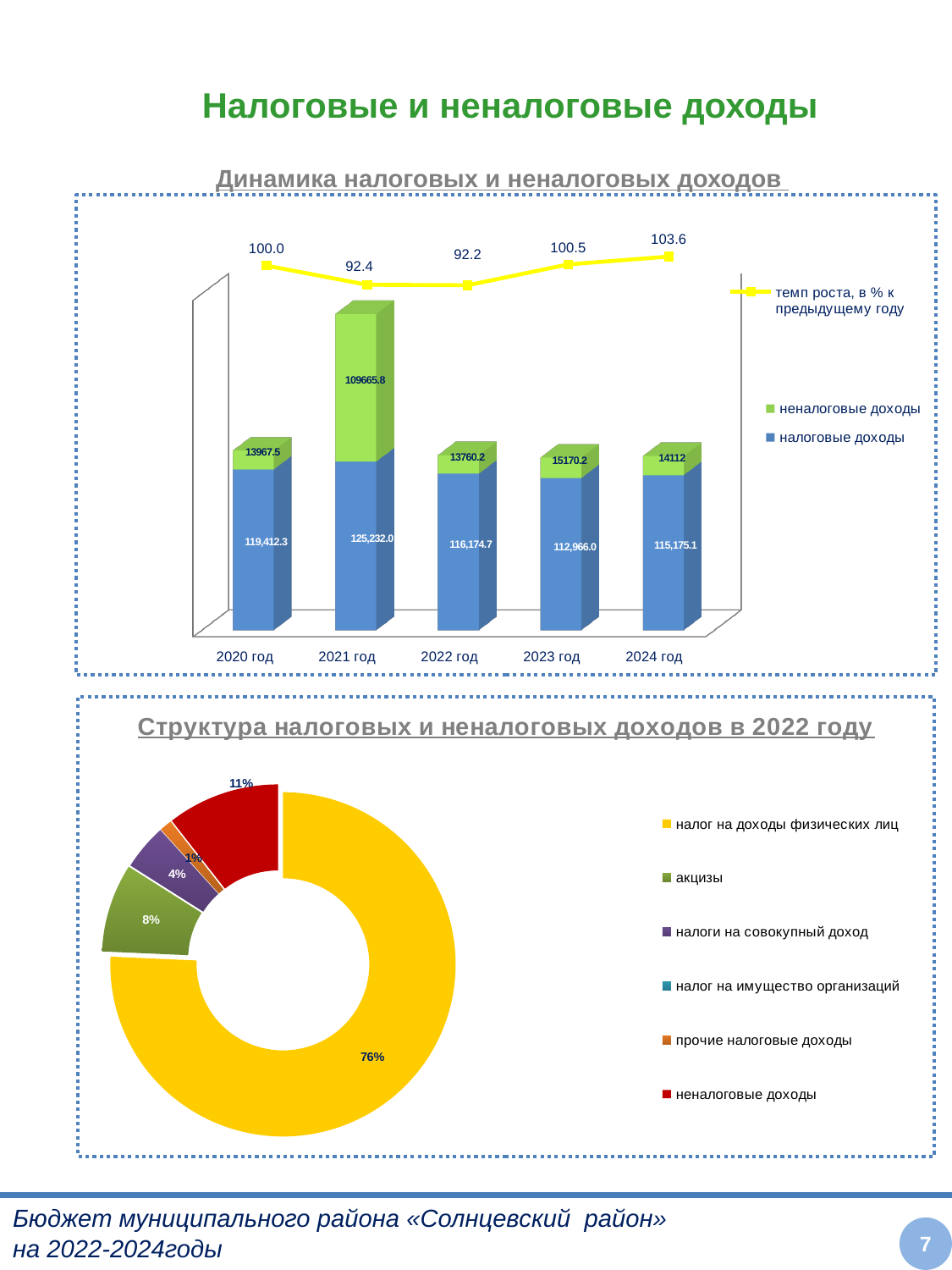
In the chart 'Структура налоговых и неналоговых доходов в 2022 году', what share does налог на доходы физических лиц have? 76% What kind of chart is 'Структура налоговых и неналоговых доходов в 2022 году'? Pie (doughnut) chart How many series does the legend of the chart 'Динамика налоговых и неналоговых доходов' list? 3 In the chart 'Динамика налоговых и неналоговых доходов', what is the темп роста value for 2024 год? 103.6 In the chart 'Структура налоговых и неналоговых доходов в 2022 году', what share does неналоговые доходы have? 11% In the chart 'Динамика налоговых и неналоговых доходов', what is the difference between налоговые доходы in 2020 год and 2023 год? 6,446.3 In the chart 'Динамика налоговых и неналоговых доходов', what is the value of неналоговые доходы for 2023 год? 15170.2 In the chart 'Динамика налоговых и неналоговых доходов', which year has the highest неналоговые доходы? 2021 год How many years are shown on the x axis of the chart 'Динамика налоговых и неналоговых доходов'? 5 In the chart 'Динамика налоговых и неналоговых доходов', which year has the lowest темп роста value? 2022 год In the chart 'Динамика налоговых и неналоговых доходов', which year has larger налоговые доходы, 2022 год or 2024 год? 2022 год In the chart 'Динамика налоговых и неналоговых доходов', what is the value of налоговые доходы for 2021 год? 125,232.0